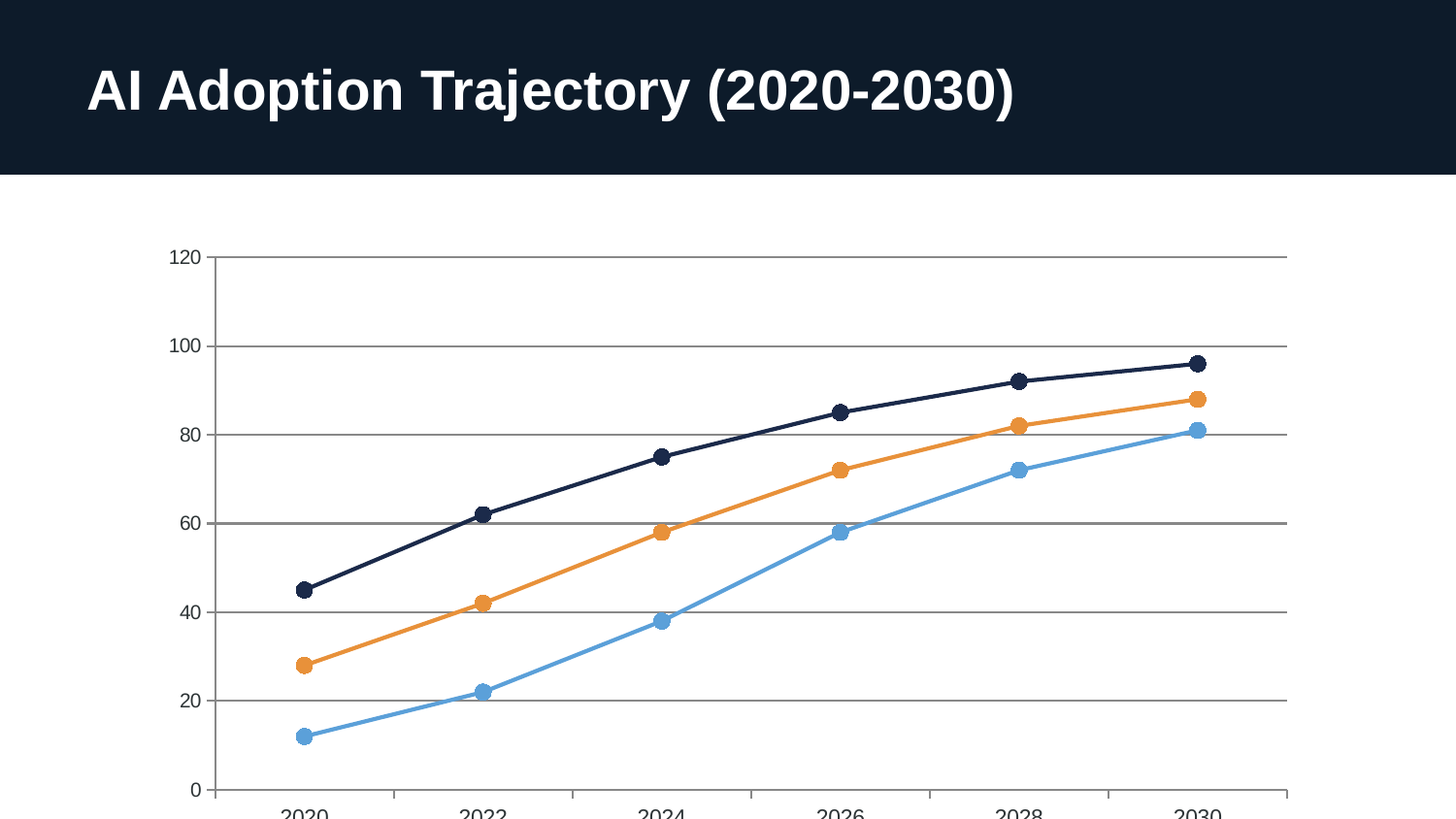
What kind of chart is shown on the slide? line chart Which line has the lowest value in 2020? light blue line In 2024, which line has the higher value, the dark navy line or the light blue line? dark navy line Is the value of the dark navy line in 2020 greater or less than 40? greater Is the value of the light blue line in 2020 greater or less than 20? less Which line has the highest values across all years on the chart? dark navy line Is the value of the orange line in 2030 greater or less than 80? greater How many years are labelled along the x axis of the chart? 6 What is the title of the chart on the slide? AI Adoption Trajectory (2020-2030) How many lines are plotted on the chart? 3 Do the values of the lines rise or fall from 2020 to 2030? rise